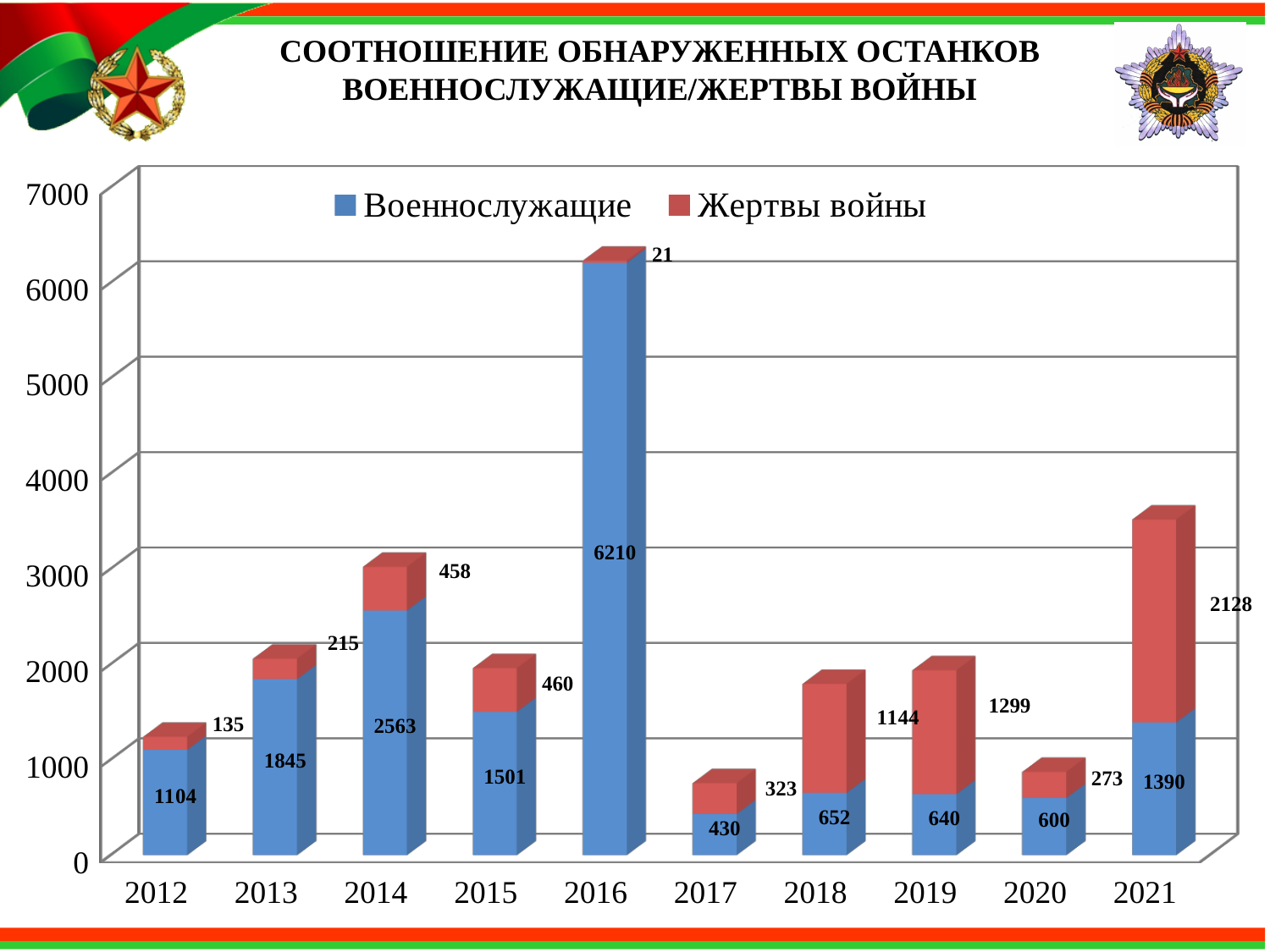
What is the value for Жертвы войны in 2012? 135 What is the total of the stacked bar for 2021? 3518 Which is larger in 2019: Военнослужащие or Жертвы войны? Жертвы войны In which year is the value for Военнослужащие the highest? 2016 What is the value for Военнослужащие in 2016? 6210 How many years are shown on the x axis? 10 In which year is the value for Жертвы войны the lowest? 2016 Which series is shown in red in the legend? Жертвы войны How many series does the legend list? 2 What is the difference between the Военнослужащие values for 2014 and 2013? 718 What type of chart is shown on the slide? stacked bar chart What is the value for Жертвы войны in 2021? 2128